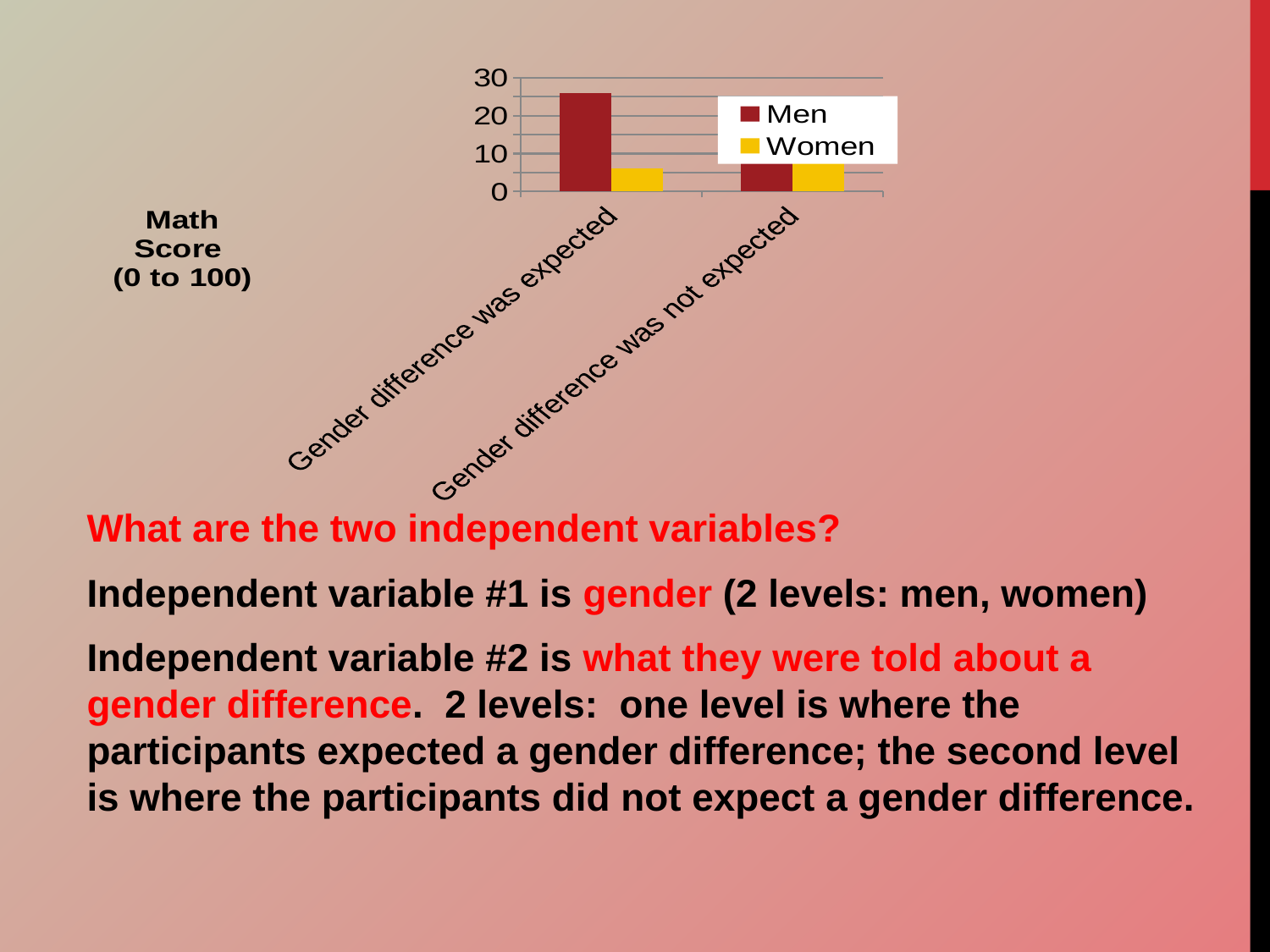
Is the value for Women in the 'Gender difference was expected' category greater or less than 10? less What does the y axis of the chart measure, according to the label on the slide? Math Score (0 to 100) How many series does the legend list? 2 What kind of chart is shown on the slide? bar chart How many categories are shown on the x axis? 2 What colour represents the Women series in the chart? yellow Which series and category has the highest bar? Men, Gender difference was expected Is the value for Men in the 'Gender difference was expected' category greater or less than 20? greater For Men, which category has the larger value, 'Gender difference was expected' or 'Gender difference was not expected'? Gender difference was expected In the 'Gender difference was expected' category, which is larger, the value for Men or the value for Women? Men